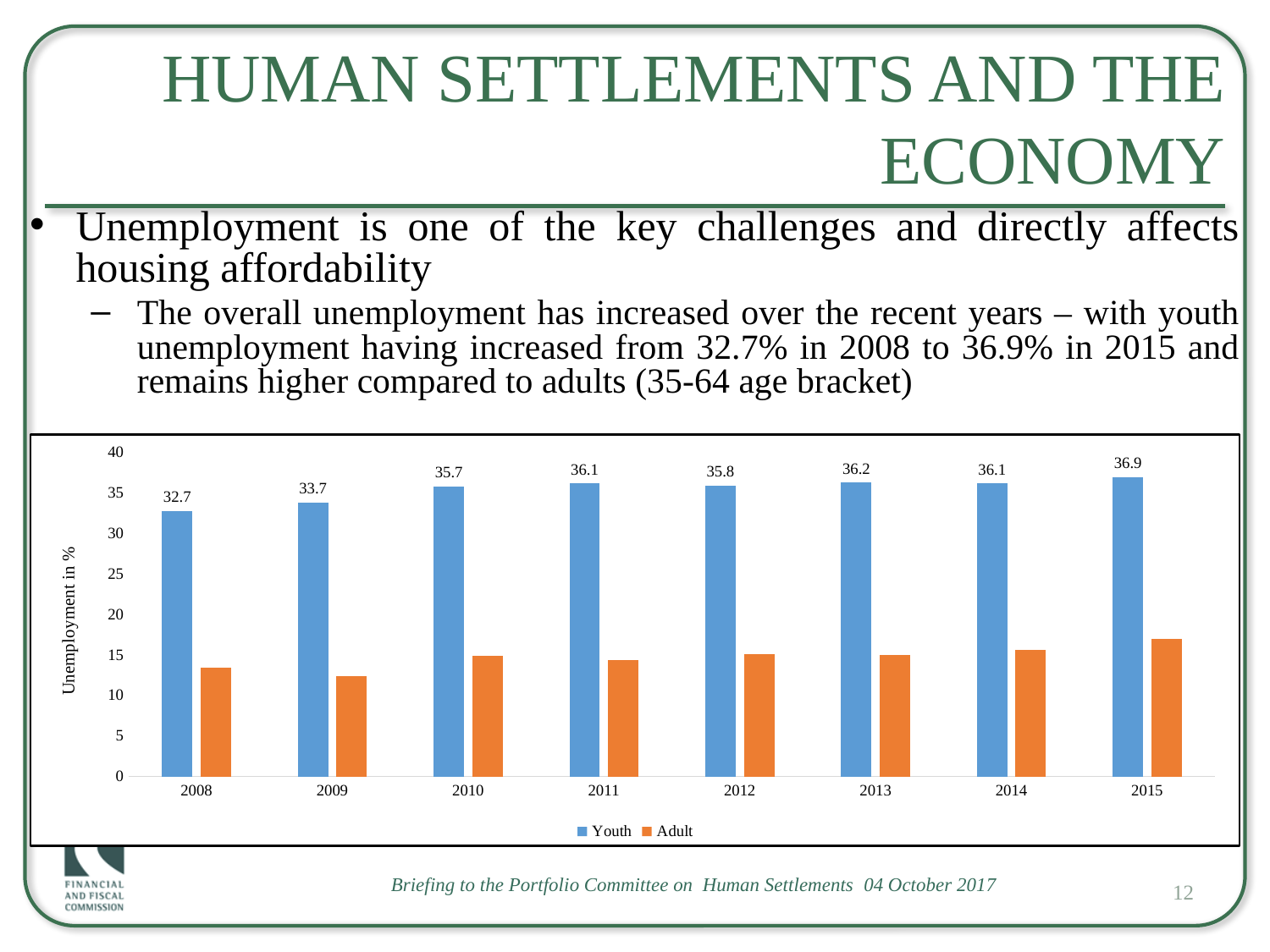
What is the Youth unemployment value for 2012? 35.8 What is the label on the vertical axis of the chart? Unemployment in % What is the Youth unemployment value for 2008? 32.7 How many series does the legend list? 2 In which year is the Youth unemployment value highest? 2015 What is the difference between the Youth unemployment values for 2015 and 2008? 4.2 Which series has the larger value in 2011, Youth or Adult? Youth Is the Adult unemployment value for 2015 greater or less than 15? greater How many years are shown on the x axis of the chart? 8 Is the Adult unemployment value for 2009 greater or less than 15? less In which year is the Youth unemployment value lowest? 2008 What kind of chart is shown on the slide? Bar chart